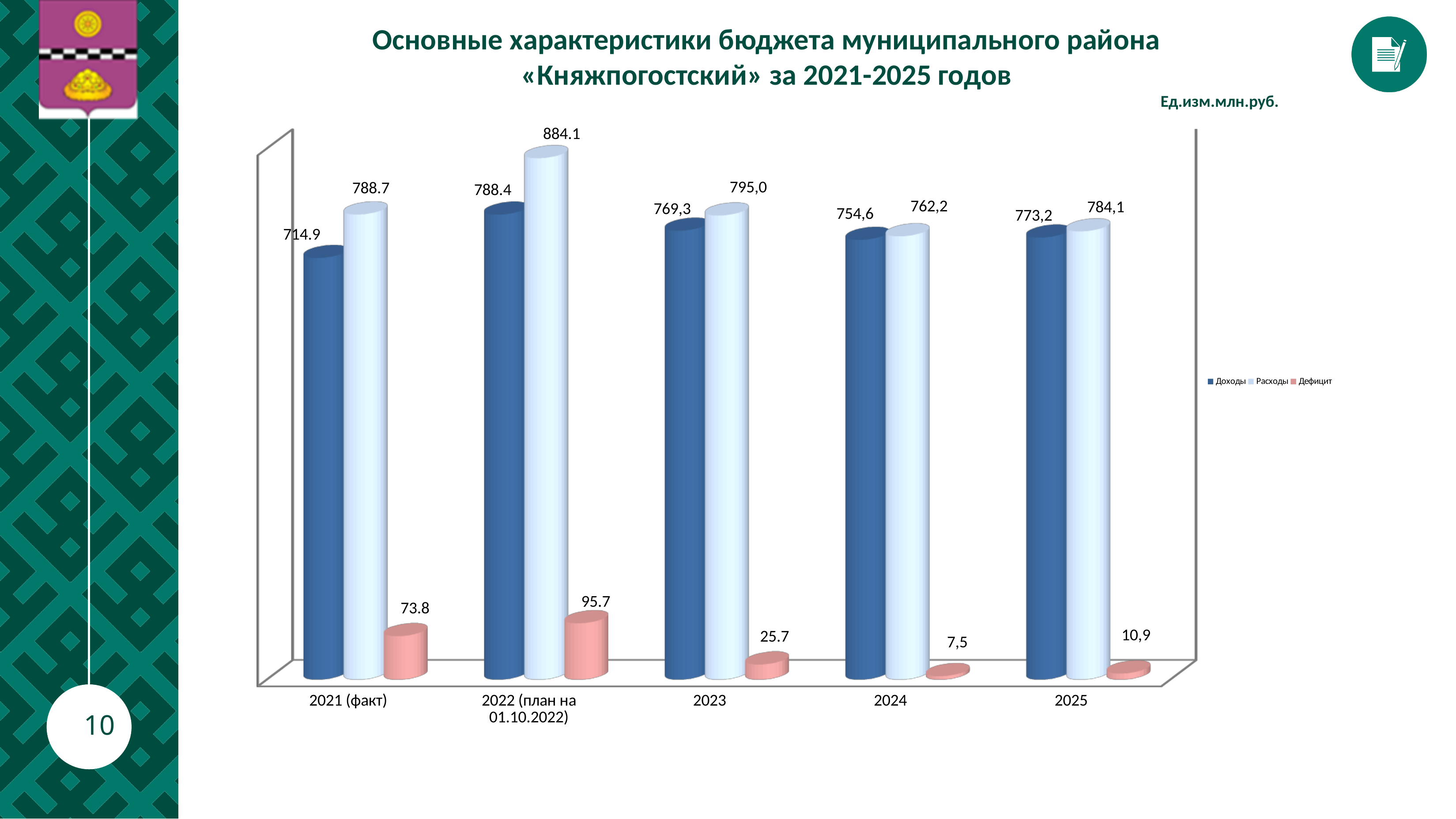
What unit of measurement is stated on the slide? млн.руб. What kind of chart is shown on the slide? Bar chart In which year is Дефицит the lowest? 2024 What is the difference between Расходы and Доходы for 2021 (факт)? 73.8 What is the value of Расходы for 2022 (план на 01.10.2022)? 884.1 What is the value of Доходы for 2021 (факт)? 714.9 Which is larger for 2023: Доходы or Расходы? Расходы In which year is Расходы the highest? 2022 (план на 01.10.2022) What is the value of Дефицит for 2024? 7,5 How many years (categories) are shown on the x axis? 5 What is the value of Доходы for 2025? 773,2 How many series does the legend list? 3